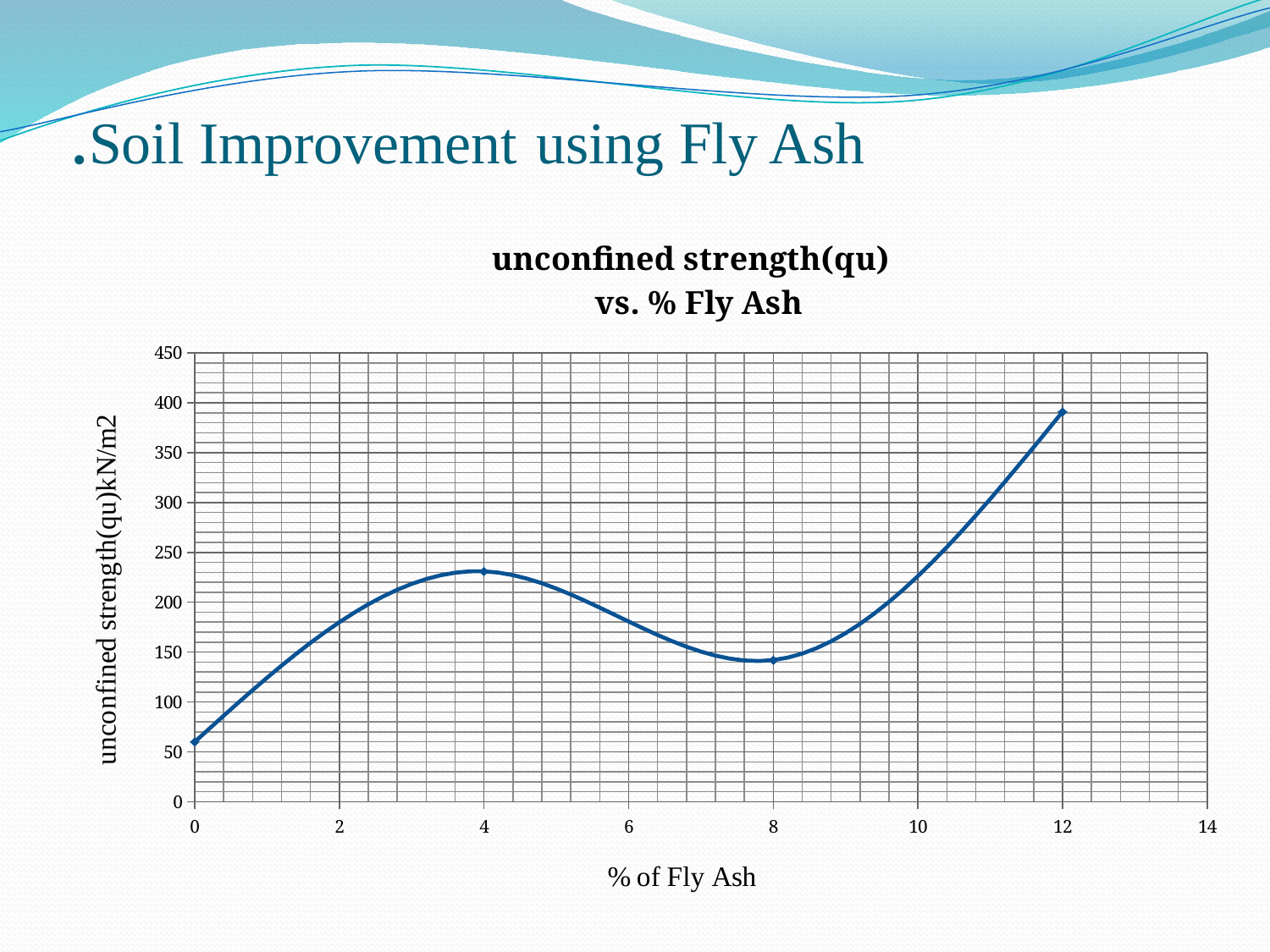
Is the unconfined strength at 8% Fly Ash greater or less than 200? less At which % of Fly Ash is the unconfined strength highest? 12 At which % of Fly Ash is the unconfined strength lowest? 0 Is the unconfined strength at 0% Fly Ash greater or less than 100? less How many data points are plotted on the line? 4 Between 4% and 8% Fly Ash, does the unconfined strength rise or fall? fall What kind of chart is shown on the slide? line chart What is the title of the chart? unconfined strength(qu) vs. % Fly Ash Which has the larger unconfined strength, 4% Fly Ash or 8% Fly Ash? 4% Fly Ash What is the label of the x axis? % of Fly Ash Is the unconfined strength at 4% Fly Ash greater or less than 200? greater